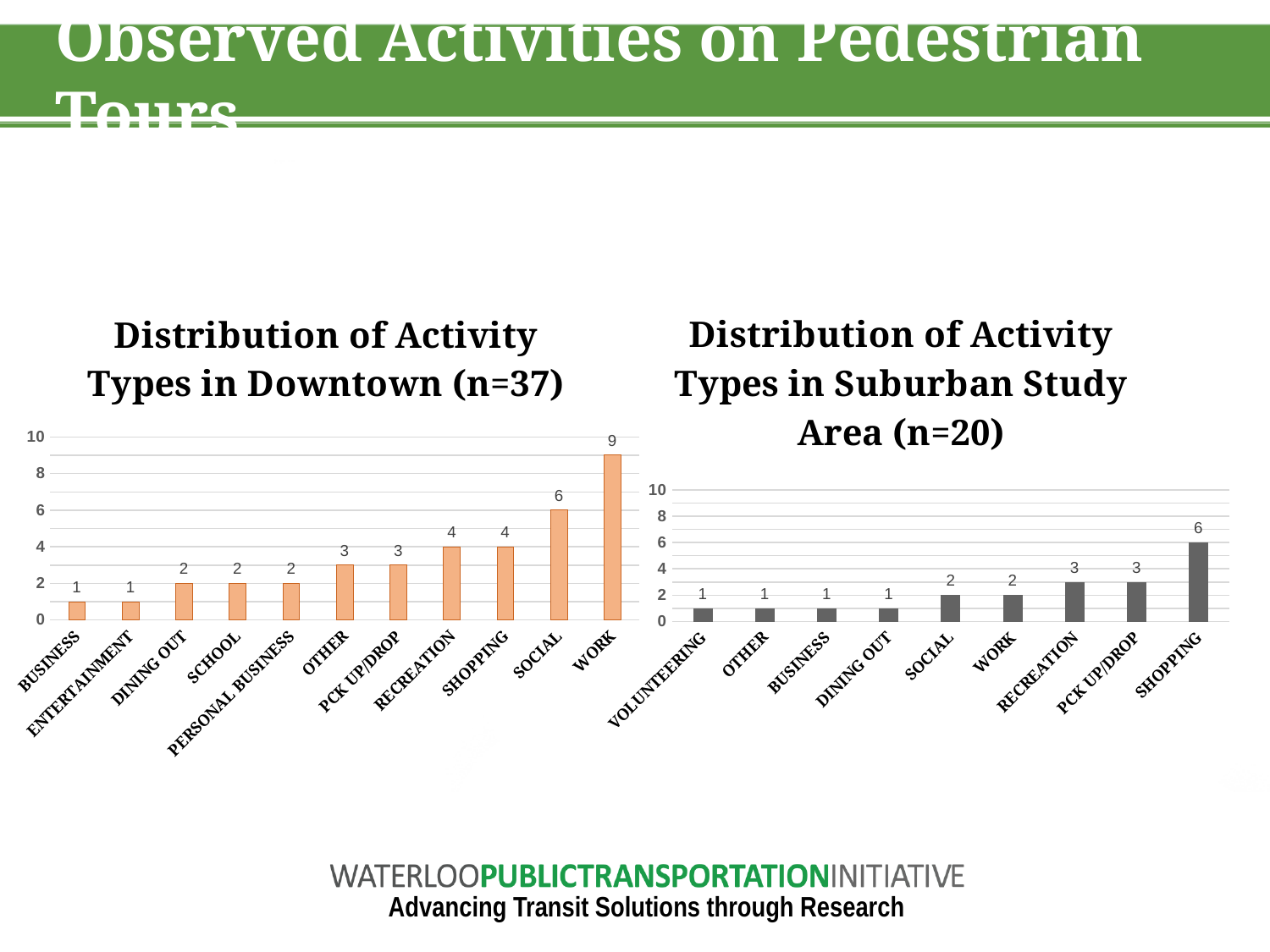
What kind of chart is the 'Distribution of Activity Types in Suburban Study Area (n=20)' chart? Bar chart How many categories are shown in the 'Distribution of Activity Types in Downtown (n=37)' chart? 11 In the 'Distribution of Activity Types in Downtown (n=37)' chart, which is larger, the value for SOCIAL or the value for SHOPPING? SOCIAL In the 'Distribution of Activity Types in Downtown (n=37)' chart, what is the value for RECREATION? 4 In the 'Distribution of Activity Types in Suburban Study Area (n=20)' chart, which category has the highest value? SHOPPING In the 'Distribution of Activity Types in Downtown (n=37)' chart, which category has the highest value? WORK In the 'Distribution of Activity Types in Suburban Study Area (n=20)' chart, what is the value for SOCIAL? 2 How many categories are shown in the 'Distribution of Activity Types in Suburban Study Area (n=20)' chart? 9 In the 'Distribution of Activity Types in Downtown (n=37)' chart, what is the value for WORK? 9 In the 'Distribution of Activity Types in Downtown (n=37)' chart, what is the difference between the values for WORK and SOCIAL? 3 In the 'Distribution of Activity Types in Suburban Study Area (n=20)' chart, what is the difference between the values for SHOPPING and RECREATION? 3 In the 'Distribution of Activity Types in Suburban Study Area (n=20)' chart, what is the value for SHOPPING? 6